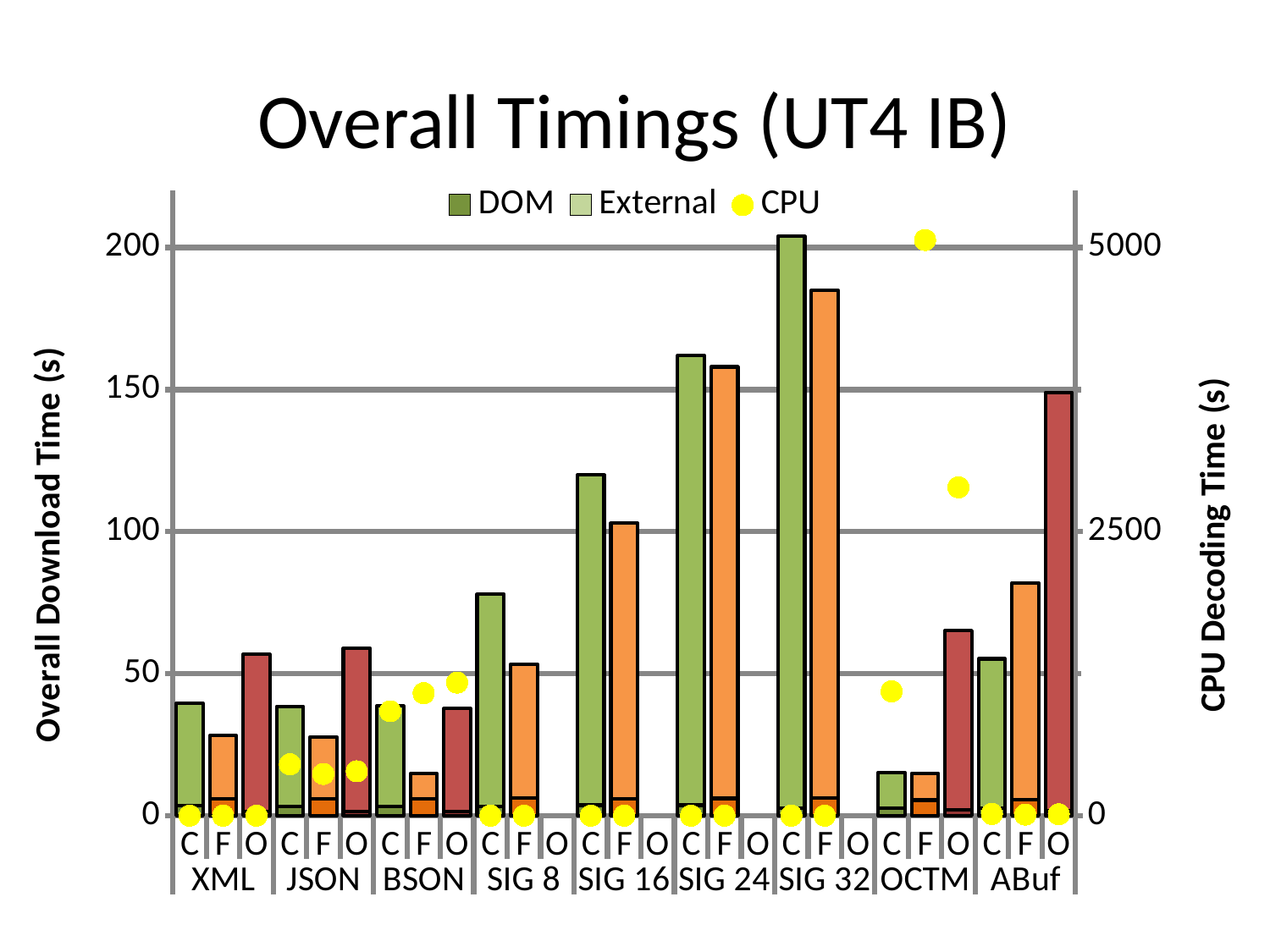
How many format groups are shown along the x axis? 9 Is the overall download time for XML C greater or less than 50? less Which bar has the highest overall download time? SIG 32 C How many series does the legend list? 3 Which has a higher overall download time, JSON O or JSON C? JSON O Is the overall download time for SIG 8 C greater or less than 100? less What kind of chart is shown on the slide? bar chart Is the overall download time for SIG 32 C greater or less than 200? greater Which has a higher overall download time, SIG 32 C or SIG 32 F? SIG 32 C What is the title of the chart? Overall Timings (UT4 IB)